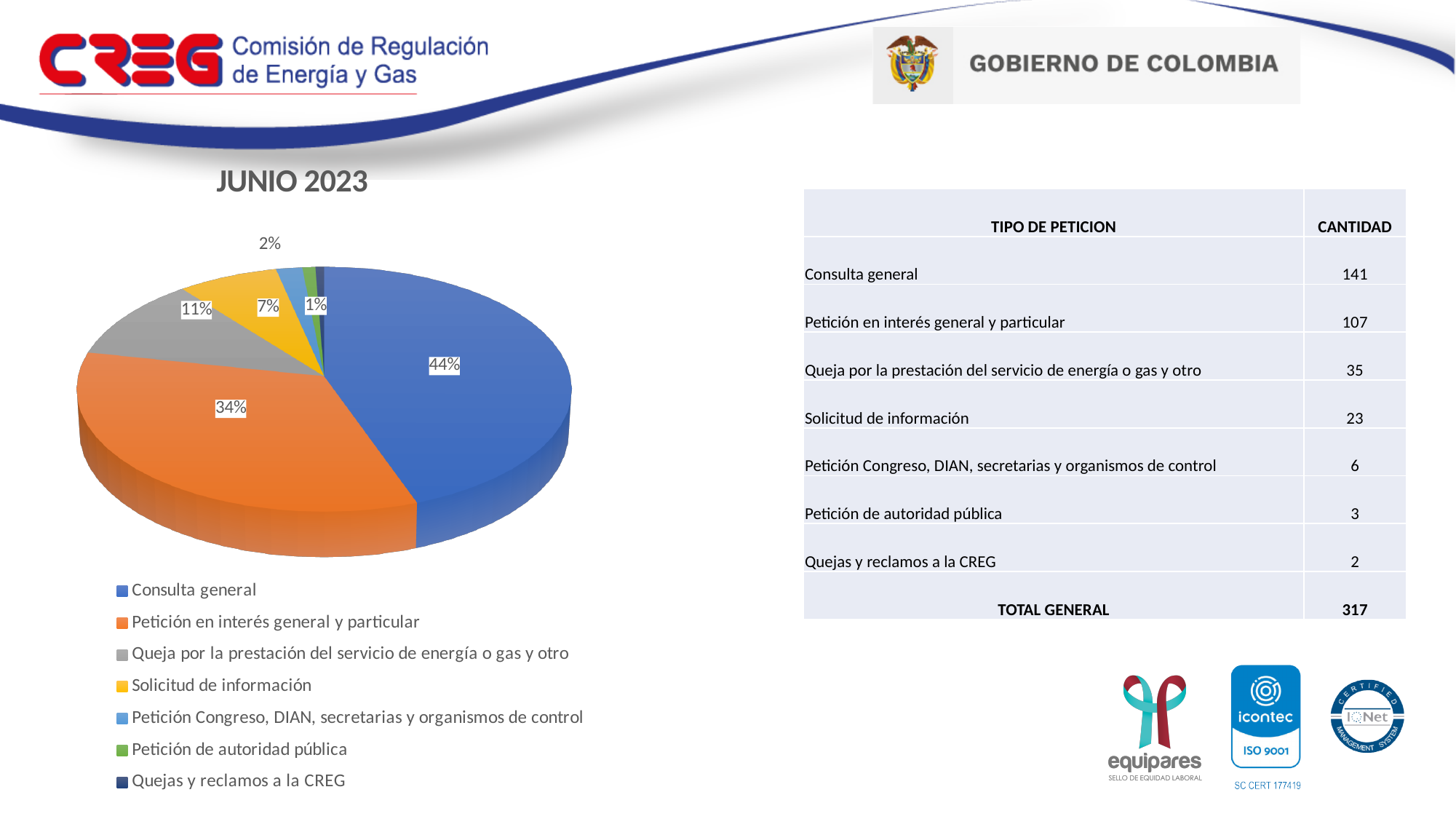
What kind of chart is shown on the slide? Pie chart By how many percentage points does the Consulta general slice exceed the Petición en interés general y particular slice? 10 percentage points What colour is the Consulta general slice in the pie chart? Blue What share of the pie does Consulta general represent? 44% What share of the pie does Petición Congreso, DIAN, secretarias y organismos de control represent? 2% How many categories does the pie chart's legend list? 7 Which category has the largest slice of the pie? Consulta general Which slice is larger: Queja por la prestación del servicio de energía o gas y otro or Solicitud de información? Queja por la prestación del servicio de energía o gas y otro What is the title of the pie chart? JUNIO 2023 What share of the pie does Queja por la prestación del servicio de energía o gas y otro represent? 11%